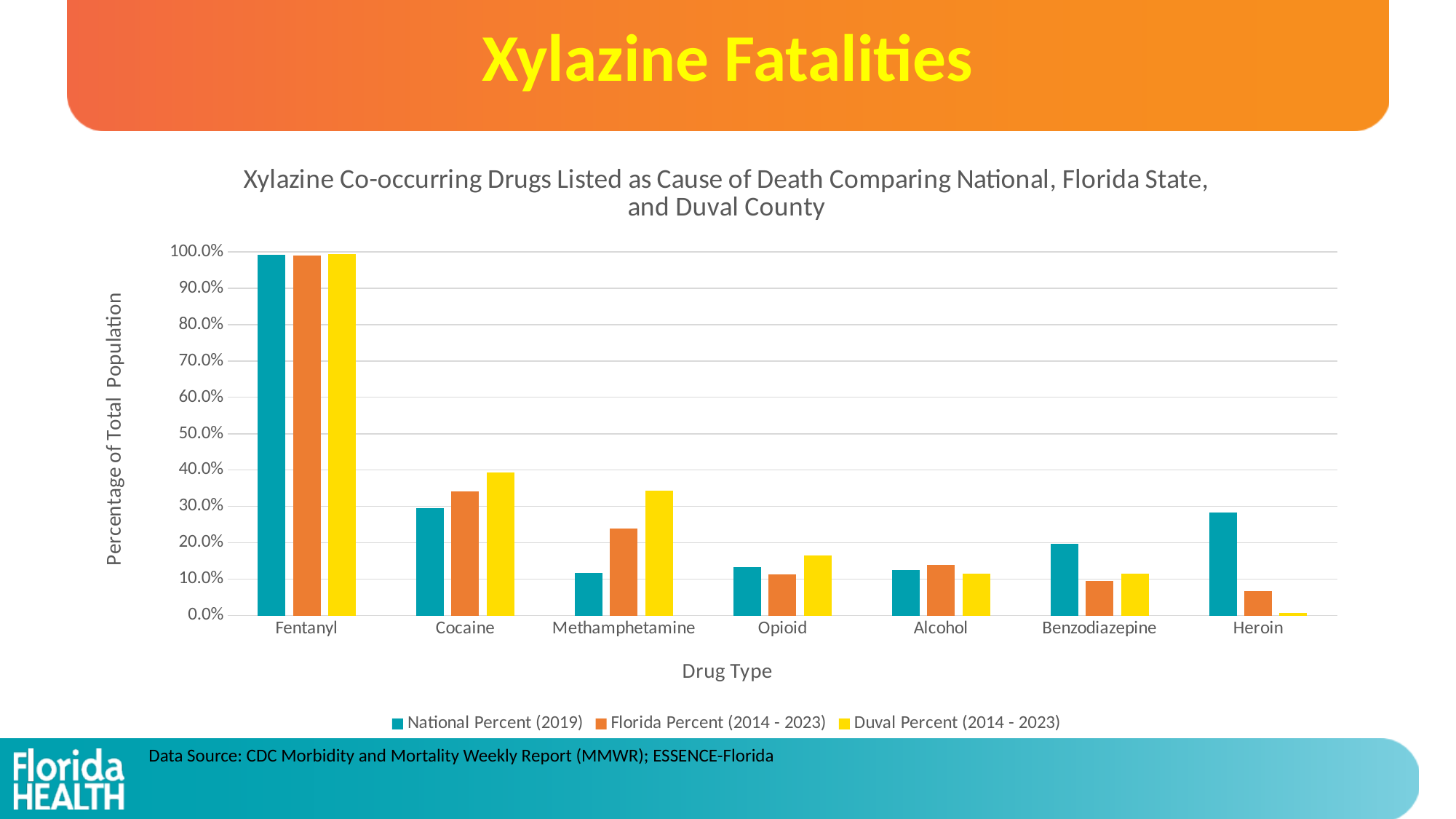
What is the title of the chart's y axis? Percentage of Total Population For Heroin, which is larger: the National Percent (2019) or the Florida Percent (2014 - 2023)? National Percent (2019) What kind of chart is shown on the slide? bar chart Which drug type has the highest Duval Percent (2014 - 2023) value? Fentanyl How many drug types are shown on the x axis of the chart? 7 Is the National Percent (2019) value for Heroin greater or less than 20.0%? greater Which drug type has the lowest Duval Percent (2014 - 2023) value? Heroin Is the Duval Percent (2014 - 2023) value for Cocaine greater or less than 30.0%? greater How many series does the chart's legend list? 3 For Methamphetamine, which is larger: the Florida Percent (2014 - 2023) or the Duval Percent (2014 - 2023)? Duval Percent (2014 - 2023) Is the Florida Percent (2014 - 2023) value for Heroin greater or less than 10.0%? less